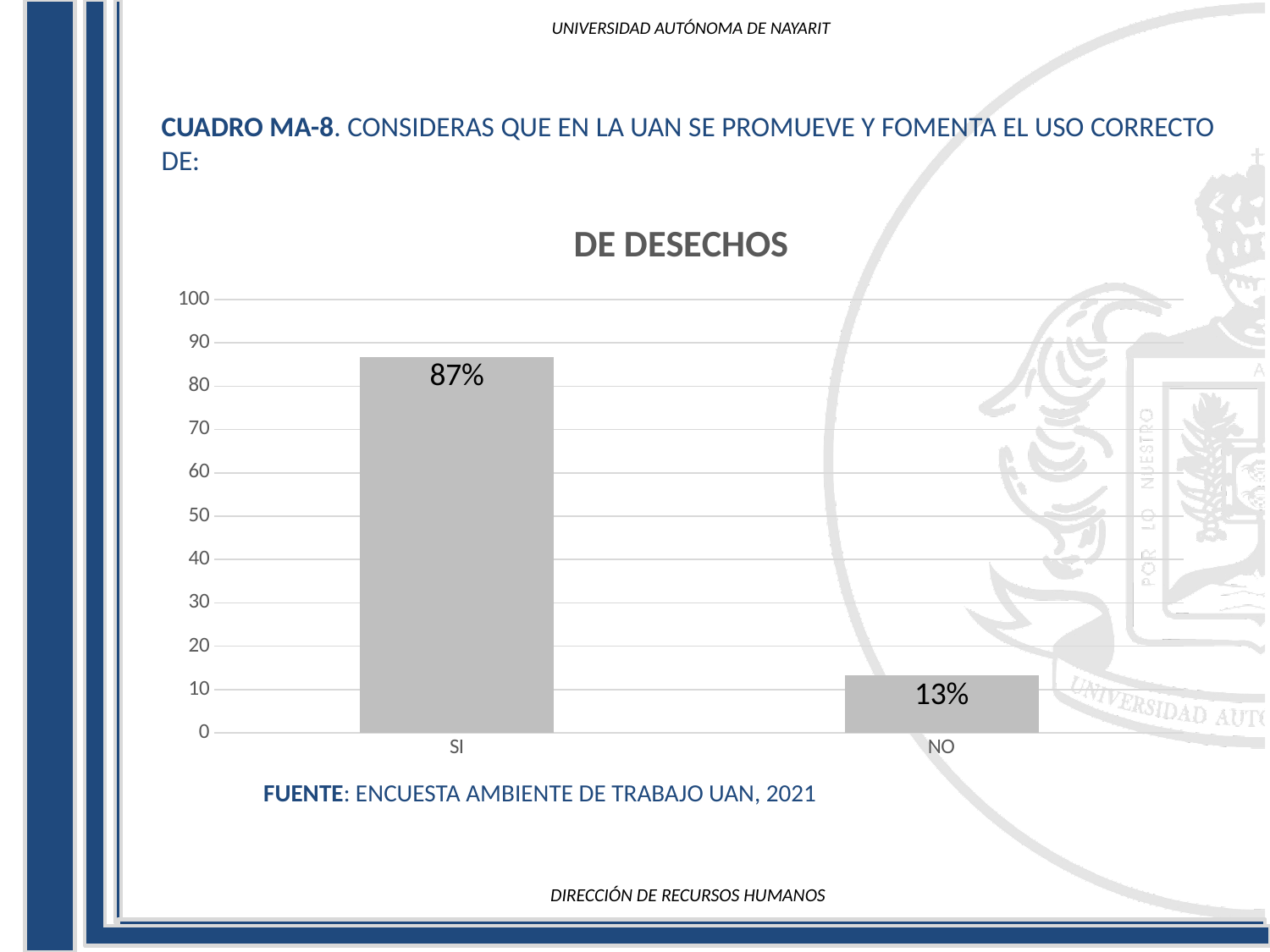
Which is larger, the value for SI or the value for NO? SI Is the value for SI greater or less than 80? greater What is the difference between the values for SI and NO? 74% What is the title of the chart? DE DESECHOS Is the value for NO greater or less than 20? less Which category has the lowest value? NO What is the value for NO? 13% Which category has the highest value? SI What kind of chart is shown on the slide? bar chart What is the maximum value shown on the y axis? 100 What is the value for SI? 87% How many categories are shown on the x axis? 2